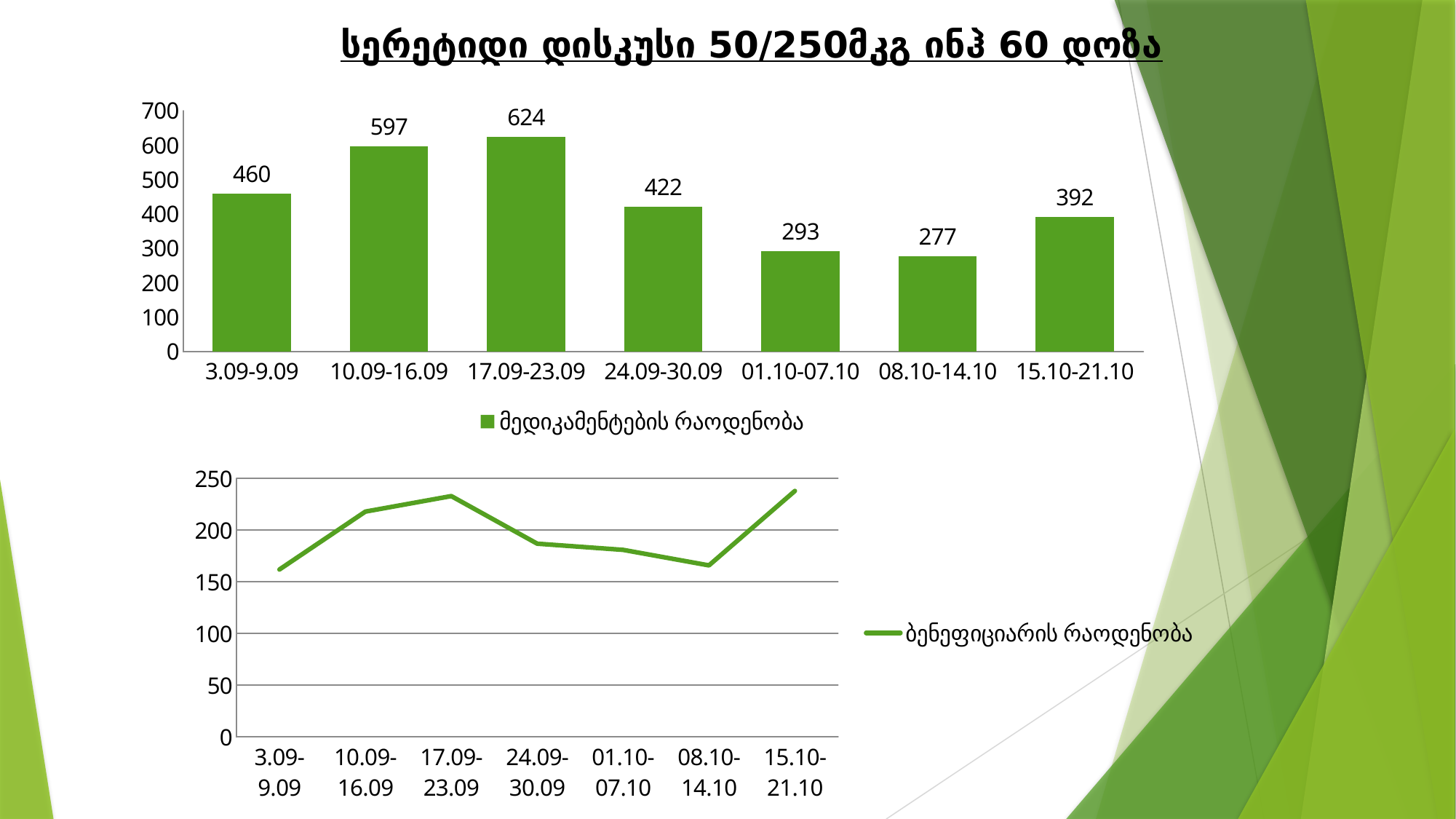
In the top bar chart, which period has the highest value? 17.09-23.09 In the top bar chart, which is larger: the value for 3.09-9.09 or the value for 15.10-21.10? 3.09-9.09 In the top bar chart, what is the difference between the values for 10.09-16.09 and 24.09-30.09? 175 In the bottom line chart, is the value for 17.09-23.09 greater or less than 200? greater In the top bar chart, what is the value for 17.09-23.09? 624 What kind of chart is the top chart on the slide? bar chart What kind of chart is the bottom chart on the slide? line chart In the top bar chart, which period has the lowest value? 08.10-14.10 In the bottom line chart, is the value for 08.10-14.10 greater or less than 200? less In the bottom line chart, does the line rise or fall between 24.09-30.09 and 08.10-14.10? fall In the top bar chart, what is the value for 08.10-14.10? 277 How many periods are shown on the x axis of the top bar chart? 7